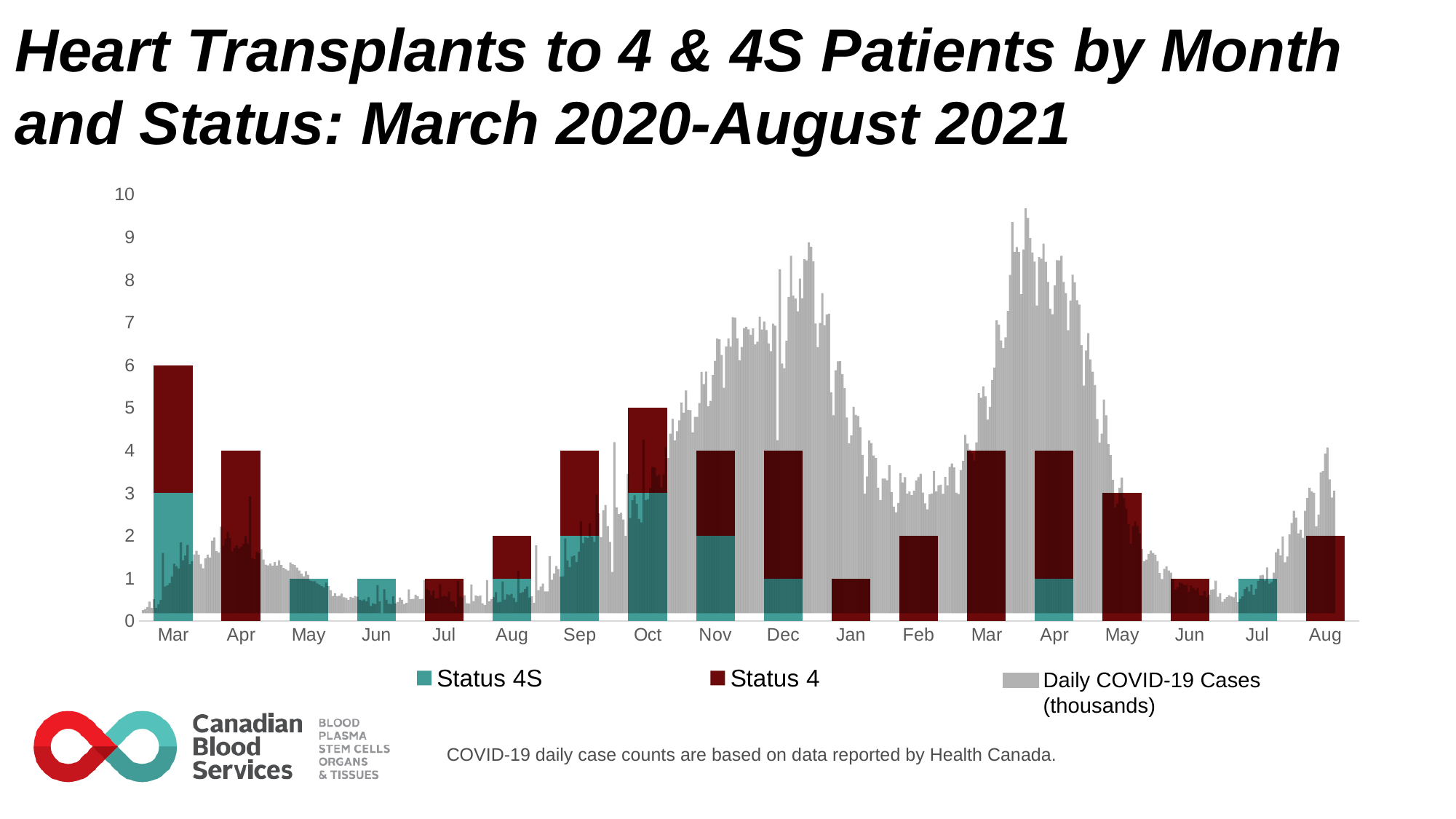
How many months are shown on the x axis? 18 What is the total height of the stacked bar for October 2020? 5 Which is larger, the total for September 2020 or the total for August 2021? September 2020 Which series is shown in grey in the legend? Daily COVID-19 Cases (thousands) What is the Status 4 value for April 2020? 4 What type of chart is used to show the heart transplants by month? Stacked bar chart Which month has the highest total number of heart transplants? Mar (2020) What is the Status 4S value for October 2020? 3 How many series does the legend list? 3 What is the total height of the stacked bar for March 2020? 6 What is the Status 4 value for December 2020? 3 What is the difference between the total for March 2020 and the total for May 2021? 3